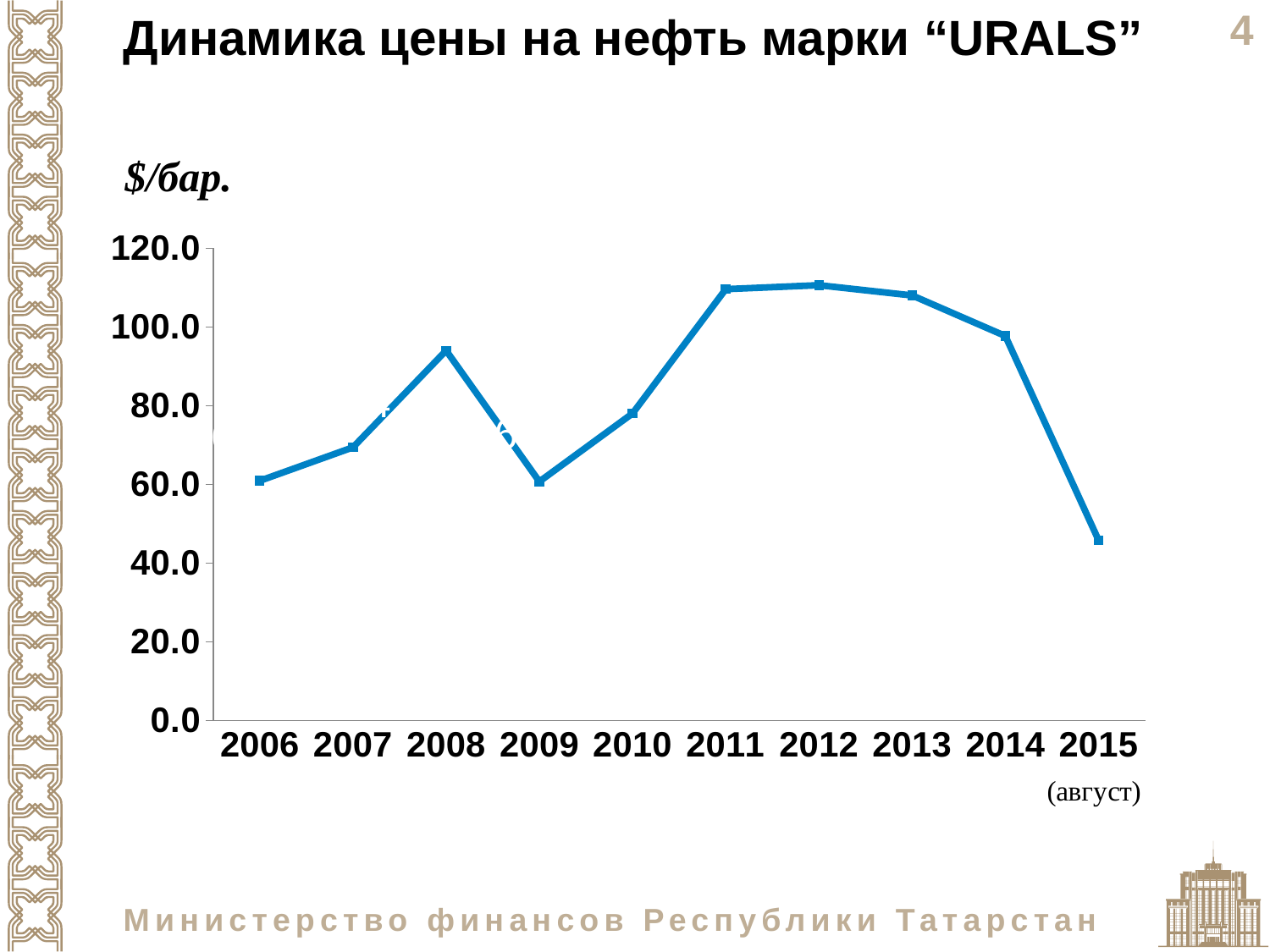
Which year has the larger value, 2014 or 2015? 2014 What unit is shown for the y axis of the chart? $/бар. Is the value for 2008 greater or less than 80.0? greater Do the values rise or fall from 2009 to 2011? rise Is the value for 2015 greater or less than 60.0? less Is the value for 2009 greater or less than 80.0? less How many years are plotted on the x axis of the chart? 10 Do the values rise or fall from 2012 to 2015? fall What kind of chart is shown on the slide? line chart Which year has the lowest Urals oil price on the chart? 2015 Which year has the larger value, 2008 or 2009? 2008